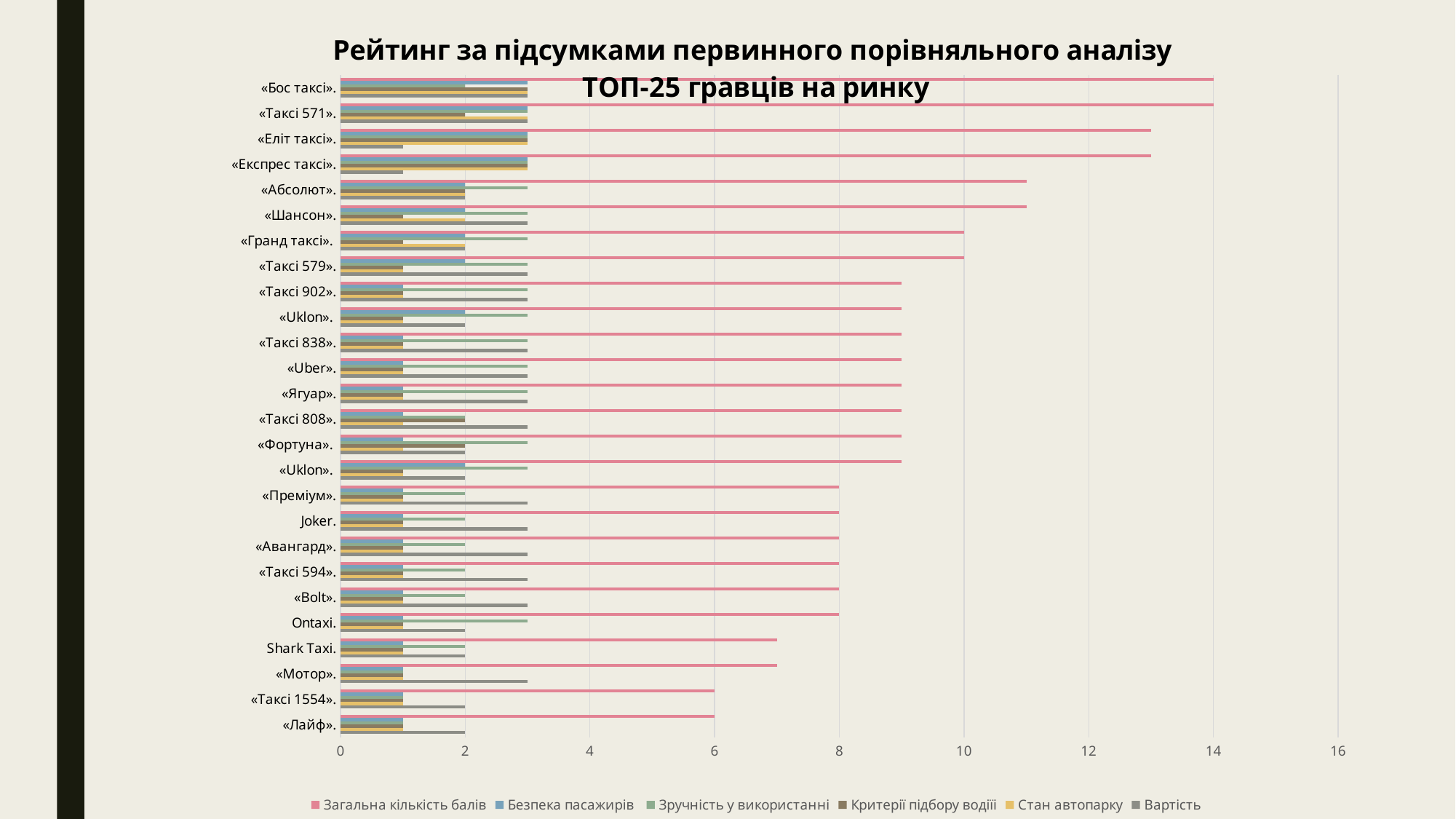
How many taxi services are listed on the vertical axis of the chart? 26 Which series is shown in pink in the legend? Загальна кількість балів Which has a higher «Загальна кількість балів» value, «Абсолют» or «Bolt»? «Абсолют» What is the value of «Загальна кількість балів» for «Бос таксі»? 14 What kind of chart is shown on the slide? bar chart What is the value of «Загальна кількість балів» for «Преміум»? 8 How many series does the legend list? 6 What is the value of «Загальна кількість балів» for «Гранд таксі»? 10 What is the difference between the «Загальна кількість балів» values for «Бос таксі» and «Лайф»? 8 Is the «Загальна кількість балів» value for «Еліт таксі» greater or less than 12? greater What is the value of «Загальна кількість балів» for «Лайф»? 6 Is the «Загальна кількість балів» value for Shark Taxi greater or less than 8? less